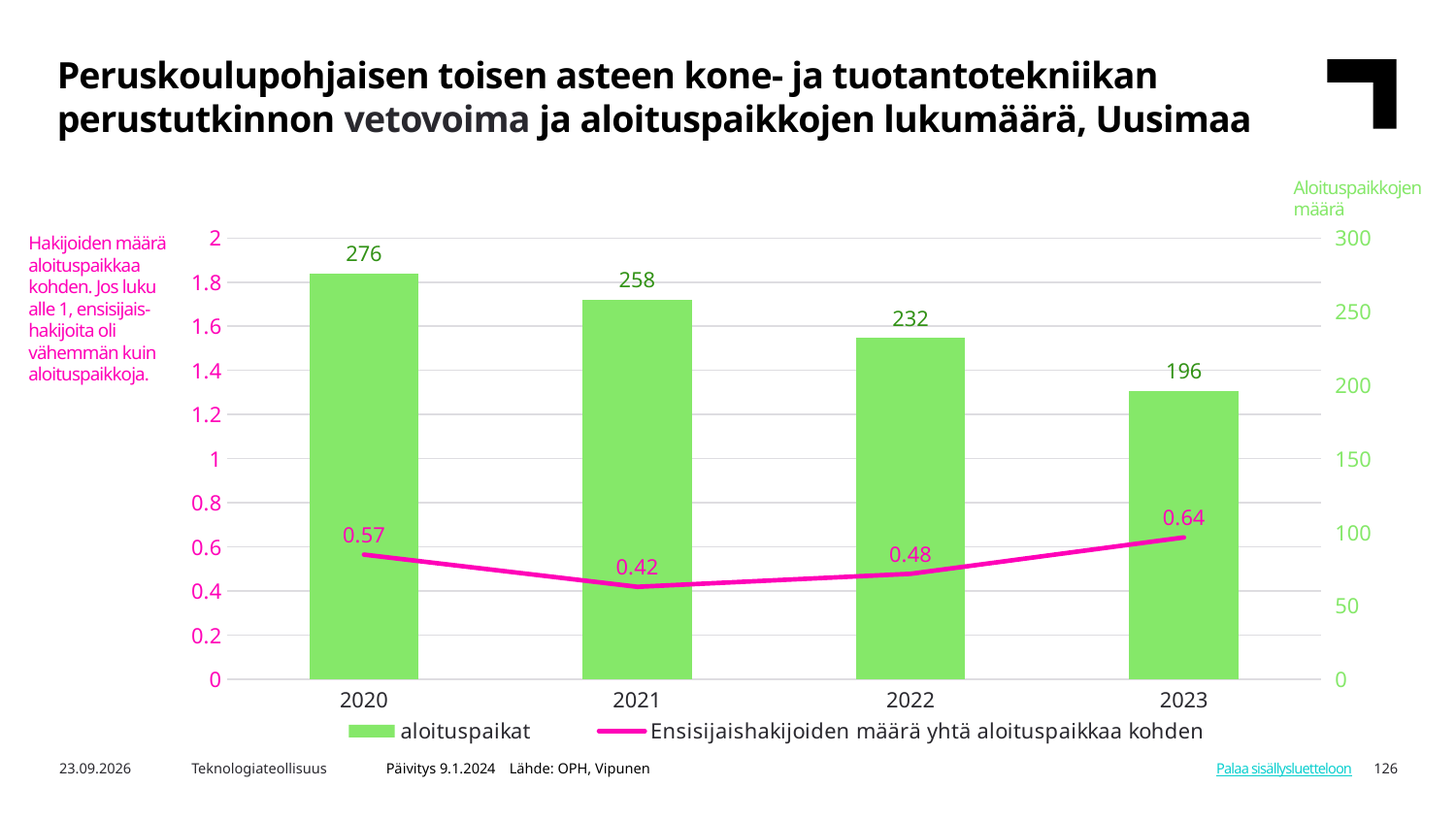
What is the value of aloituspaikat in 2023? 196 What is the value of Ensisijaishakijoiden määrä yhtä aloituspaikkaa kohden in 2021? 0.42 What is the difference between the aloituspaikat values for 2020 and 2023? 80 Is the aloituspaikat value for 2022 greater or less than 200? greater How many years are shown on the x axis? 4 Which year has the highest value for aloituspaikat? 2020 What is the value of aloituspaikat in 2020? 276 How many series does the legend list? 2 Which is larger, the Ensisijaishakijoiden määrä yhtä aloituspaikkaa kohden value for 2020 or for 2022? 2020 Does the aloituspaikat series rise or fall from 2020 to 2023? fall Which year has the lowest value for Ensisijaishakijoiden määrä yhtä aloituspaikkaa kohden? 2021 What colour are the aloituspaikat bars? green